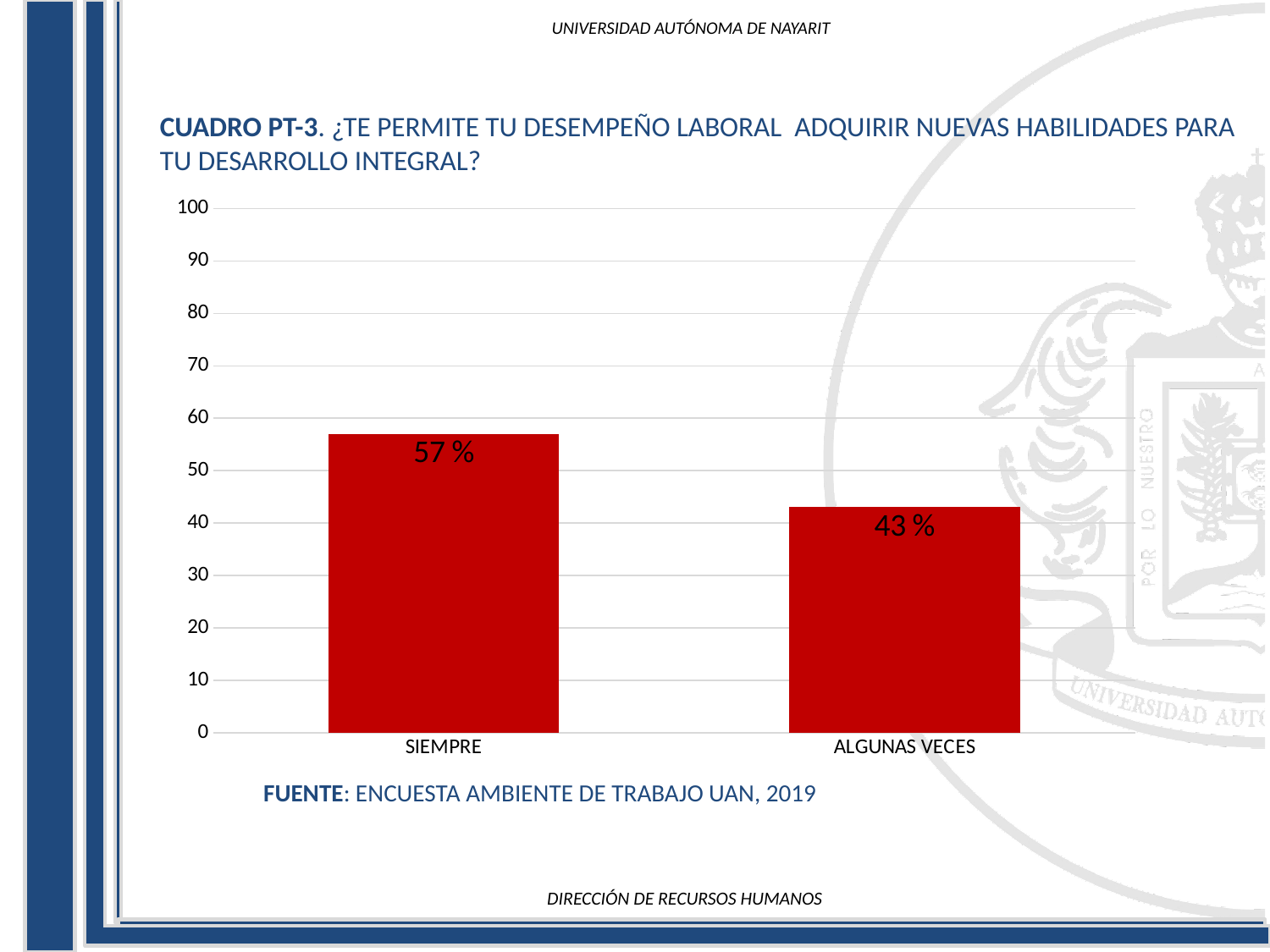
Which is larger, the value for SIEMPRE or the value for ALGUNAS VECES? SIEMPRE What kind of chart is shown on the slide? bar chart What is the value for ALGUNAS VECES? 43 % How many categories are shown on the x axis? 2 What is the source cited below the chart? ENCUESTA AMBIENTE DE TRABAJO UAN, 2019 What is the value for SIEMPRE? 57 % Is the value for SIEMPRE greater or less than 50? greater Which category has the lowest value? ALGUNAS VECES Which category has the highest value? SIEMPRE What colour are the bars in the chart? red Is the value for ALGUNAS VECES greater or less than 50? less What is the difference between the values for SIEMPRE and ALGUNAS VECES? 14 %